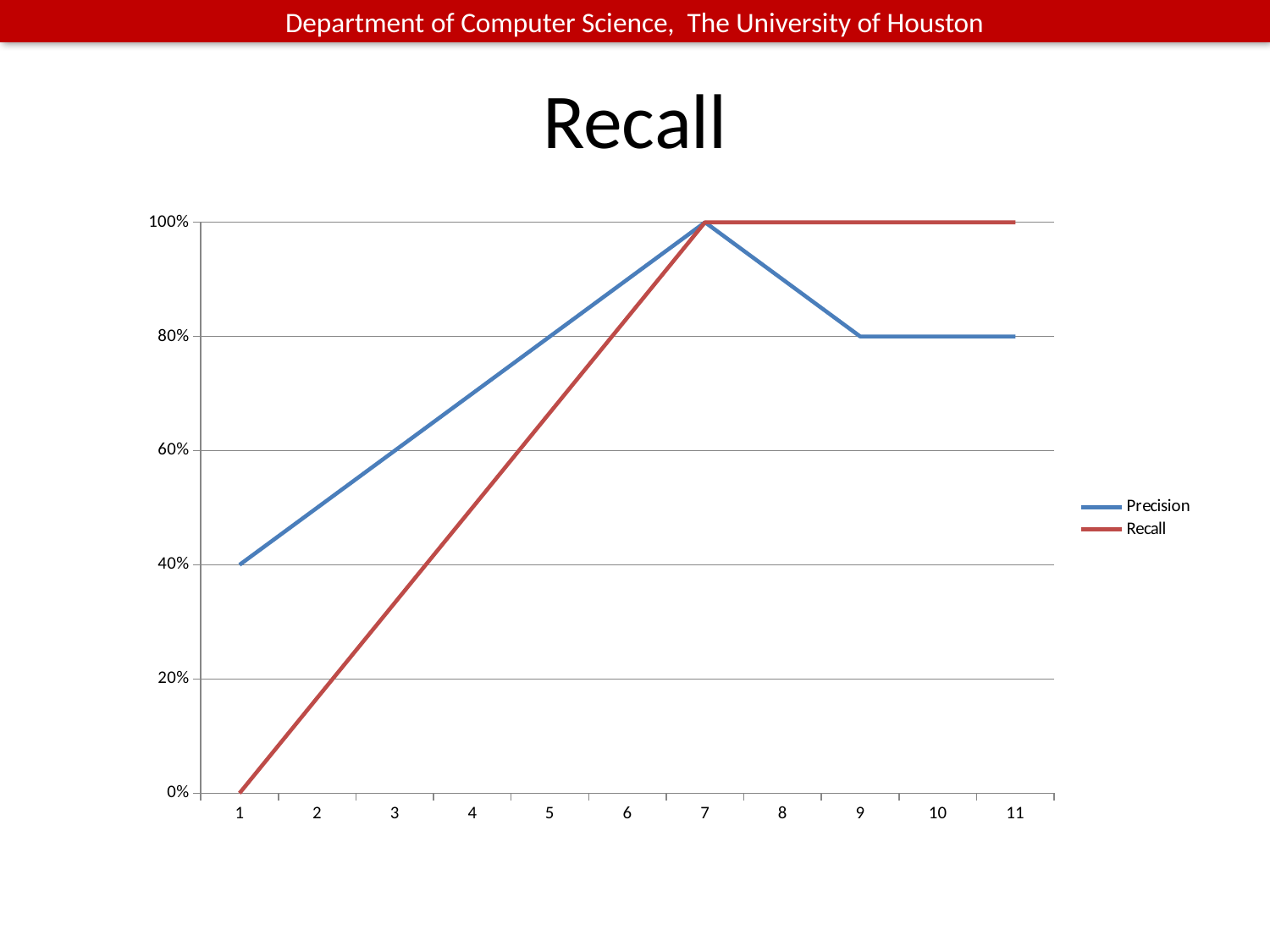
What is the Precision value at x = 1? 40% How many points are labelled along the x axis? 11 What is the Recall value at x = 1? 0% At which x value is Recall at its lowest? 1 What is the difference between the Precision value at x = 7 and at x = 11? 20% At which x value does Precision reach its highest point? 7 How many series does the legend list? 2 At x = 1, which series has the larger value, Precision or Recall? Precision What kind of chart is shown on the slide? line chart Is the Precision value at x = 4 greater or less than 60%? greater What is the Precision value at x = 9? 80% What is the Recall value at x = 11? 100%